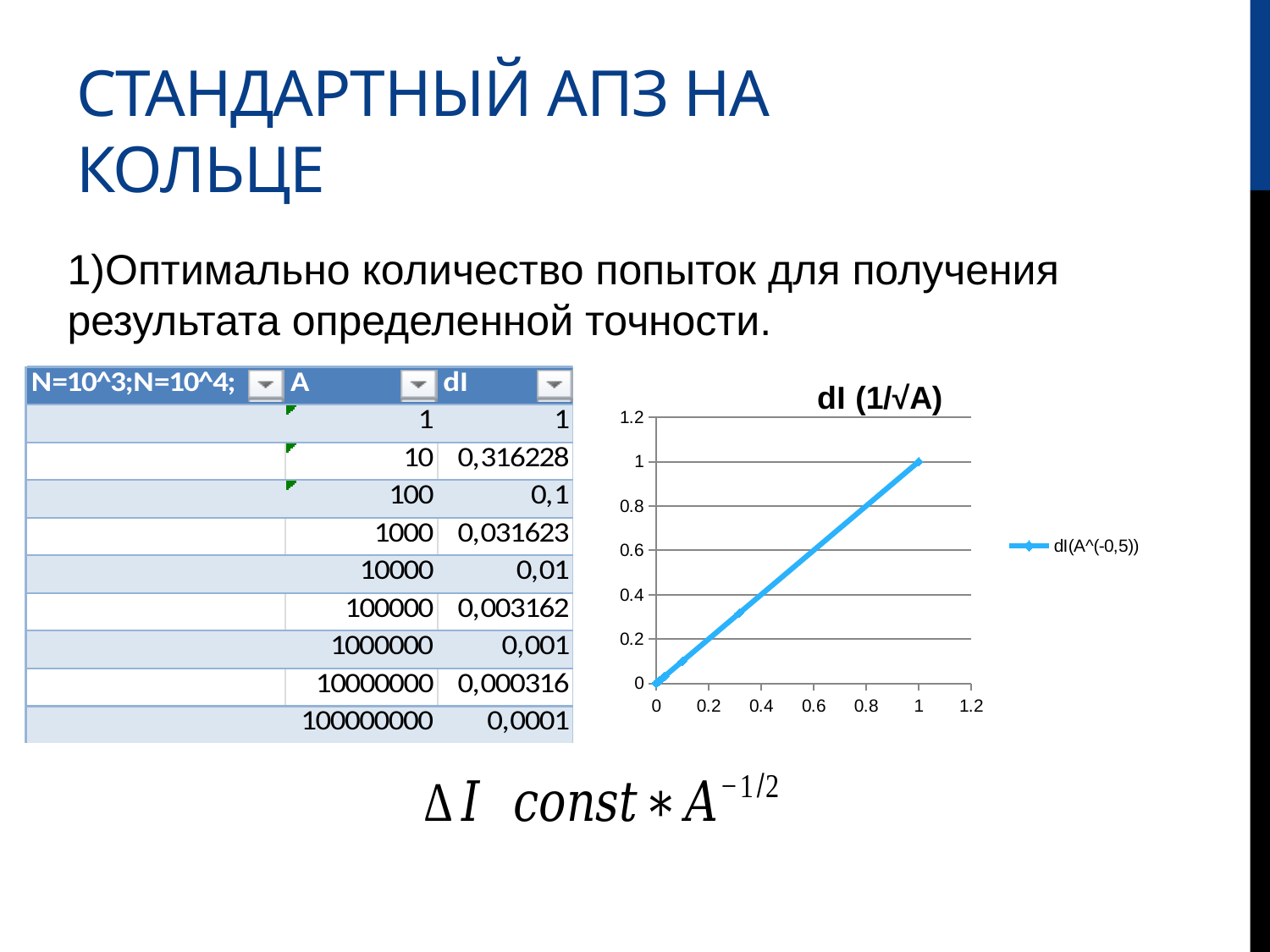
What is the name of the series shown in the chart legend? dI(A^(-0,5)) What is the y value of the plotted line at x = 0? 0 What kind of chart is shown on the slide? line chart Is the value of the line at x = 0.8 greater or less than 0.6? greater Is the value of the line at x = 0.4 greater or less than 0.6? less Does the plotted line rise or fall as the x value increases? rises How many series does the chart legend list? 1 What is the title of the chart? dI (1/√A) What is the highest tick value shown on the y axis of the chart? 1.2 What is the y value of the plotted line at x = 1? 1